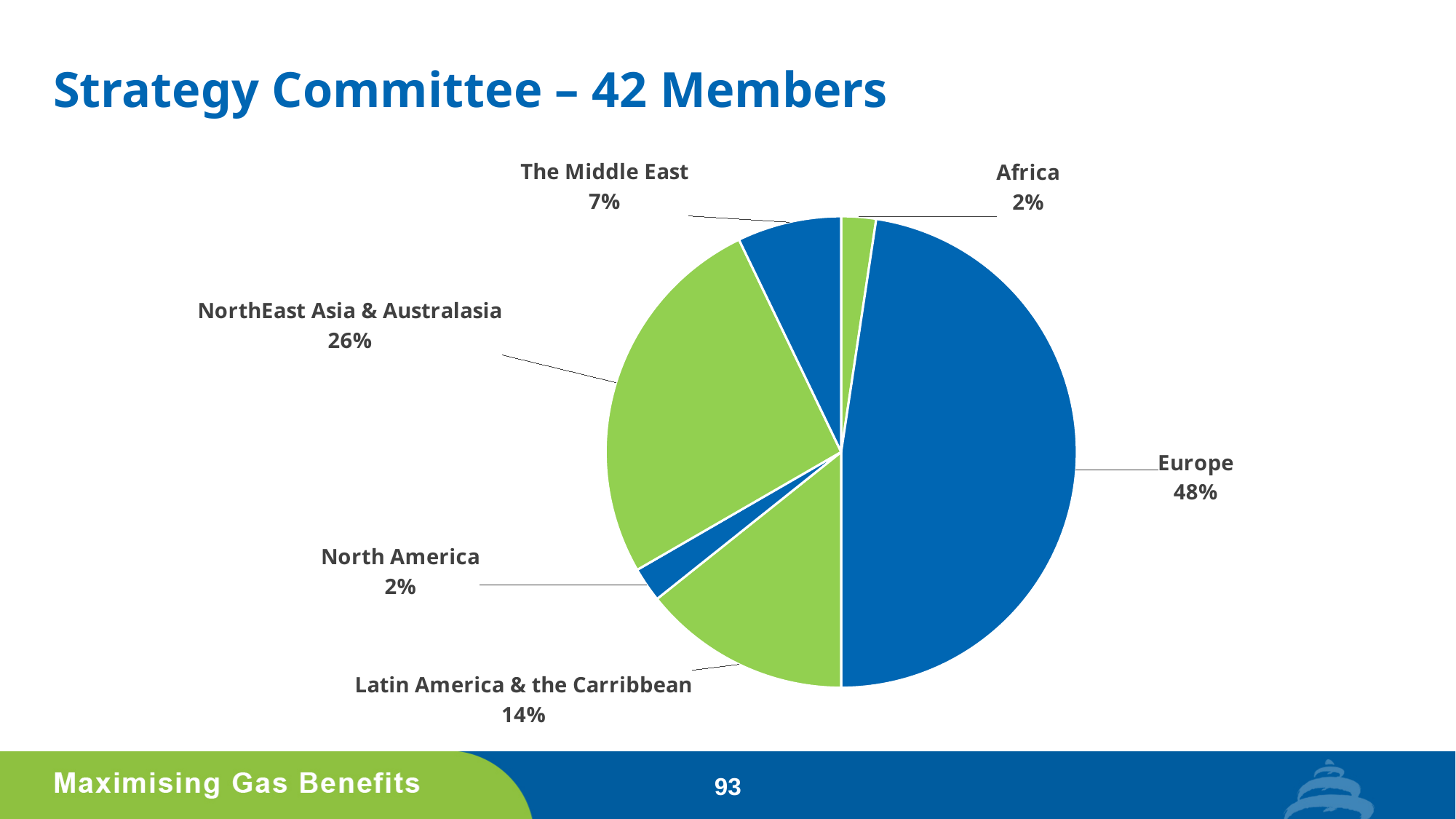
What percentage is shown for Latin America & the Carribbean? 14% What is the value shown for NorthEast Asia & Australasia? 26% Which region has the largest slice of the pie? Europe Which is larger, the slice for Latin America & the Carribbean or the slice for The Middle East? Latin America & the Carribbean What is the difference in percentage points between Europe and NorthEast Asia & Australasia? 22 What colour is the Europe slice? Blue What is the value for The Middle East? 7% How many slices does the pie chart have? 6 What is the combined share of Africa and North America? 4% What share of the pie does Europe hold? 48% What is the title of the slide containing the chart? Strategy Committee – 42 Members What kind of chart is shown on the slide? Pie chart